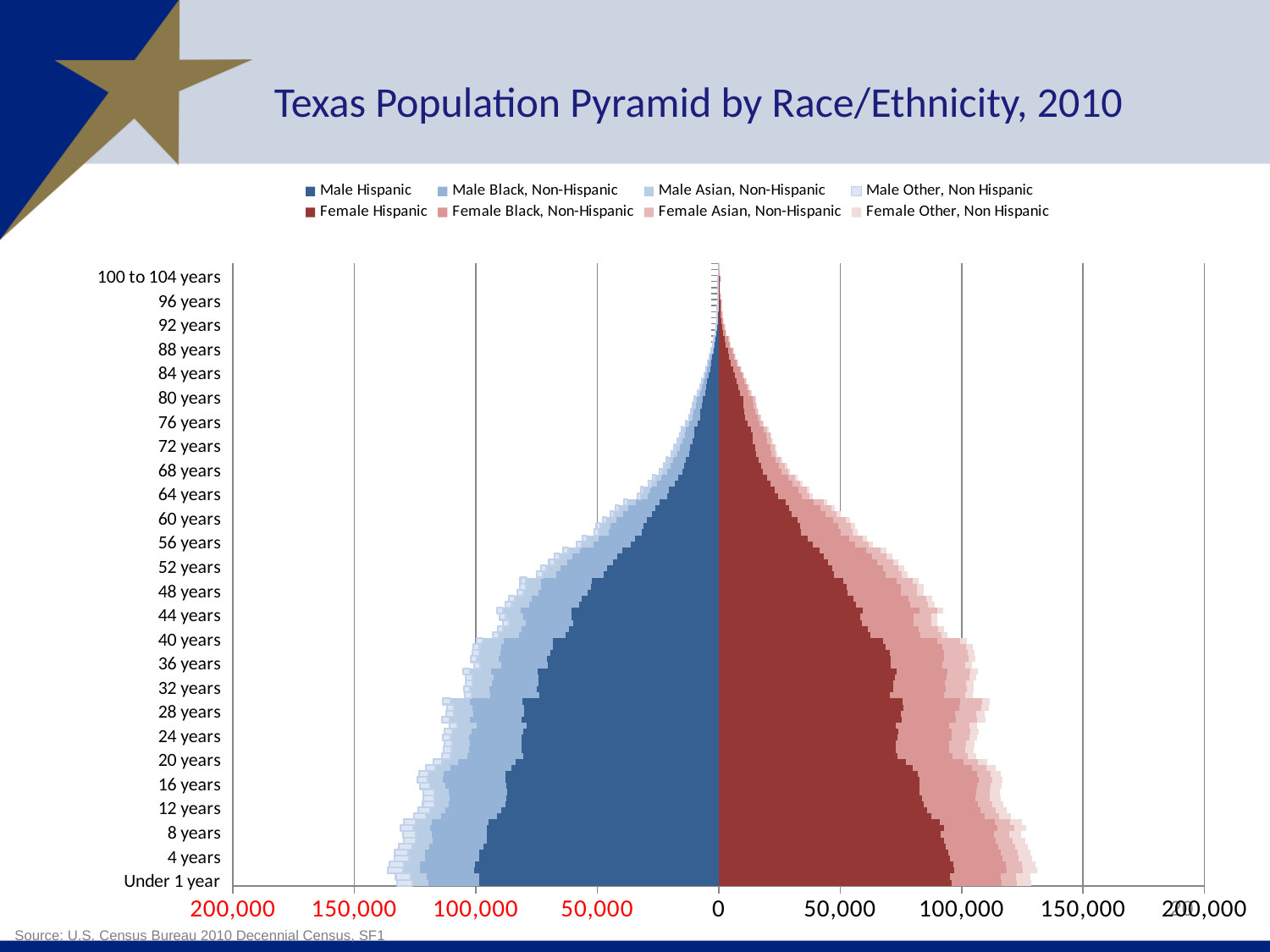
Is the Male Hispanic segment for Under 1 year greater or less than 50,000? greater On which side of the chart are the male series plotted? Left Is the total female bar for Under 1 year greater or less than 100,000? greater Is the total female bar for 80 years greater or less than 50,000? less How many series does the legend list? 8 Which has a larger total male population, 40 years or 80 years? 40 years Do the bar lengths generally rise or fall as age increases from Under 1 year to 100 to 104 years? fall What kind of chart is shown on the slide? Bar chart (population pyramid) What is the title of the chart? Texas Population Pyramid by Race/Ethnicity, 2010